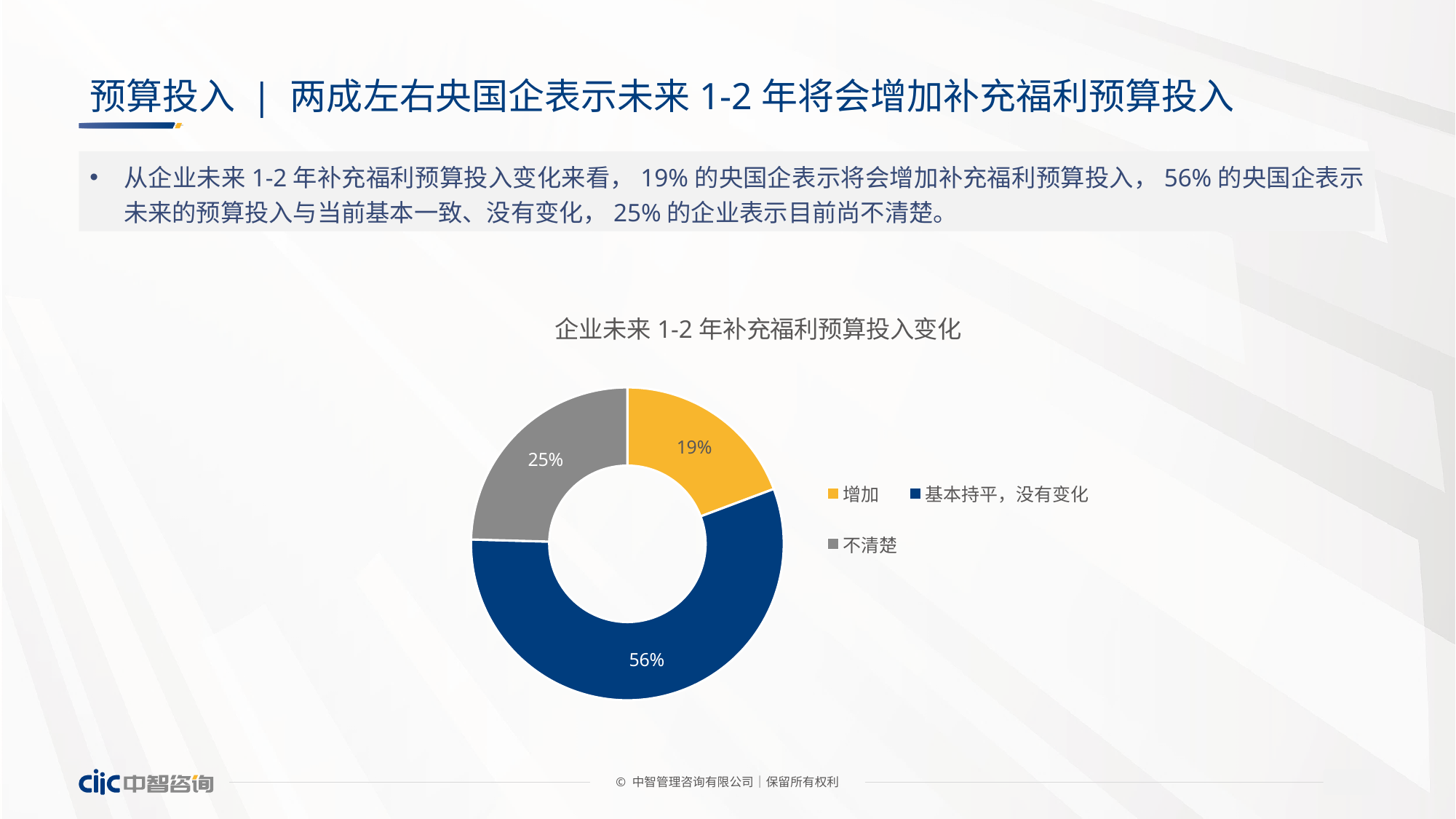
What is the difference between the values for 不清楚 and 增加? 6% What is the value for 基本持平，没有变化 in the chart? 56% What is the title of the chart? 企业未来 1-2 年补充福利预算投入变化 What is the value for 不清楚 in the chart? 25% What kind of chart is shown on the slide? Doughnut (pie) chart Which category has the largest share in the chart? 基本持平，没有变化 What is the value for 增加 in the chart 企业未来 1-2 年补充福利预算投入变化? 19% Which category has the smallest share in the chart? 增加 What is the difference between the values for 基本持平，没有变化 and 不清楚? 31% How many categories are shown in the chart? 3 Which is larger, the value for 不清楚 or the value for 增加? 不清楚 What colour represents 不清楚 in the chart? Grey